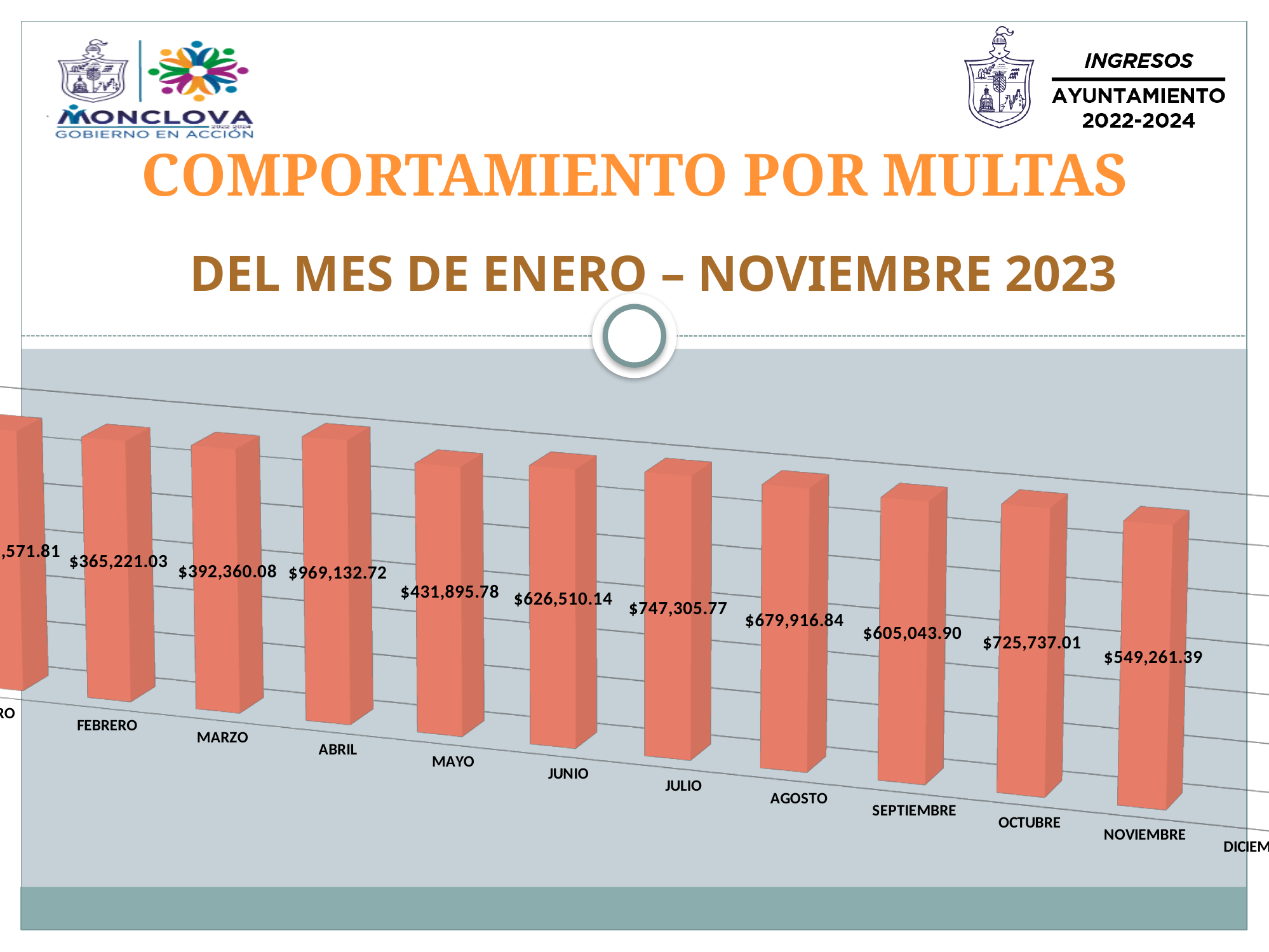
What is the value for FEBRERO? $365,221.03 What is the value for SEPTIEMBRE? $605,043.90 What is the value for NOVIEMBRE? $549,261.39 Do the values rise or fall from JULIO to SEPTIEMBRE? fall What is the difference between the values for JULIO and JUNIO? $120,795.63 What is the difference between the values for OCTUBRE and NOVIEMBRE? $176,475.62 What is the value for JULIO? $747,305.77 What is the title of the chart on the slide? COMPORTAMIENTO POR MULTAS What kind of chart is shown on the slide? bar chart Which is larger, the value for JUNIO or the value for JULIO? JULIO What is the value for ABRIL? $969,132.72 Which is larger, the value for MAYO or the value for ABRIL? ABRIL